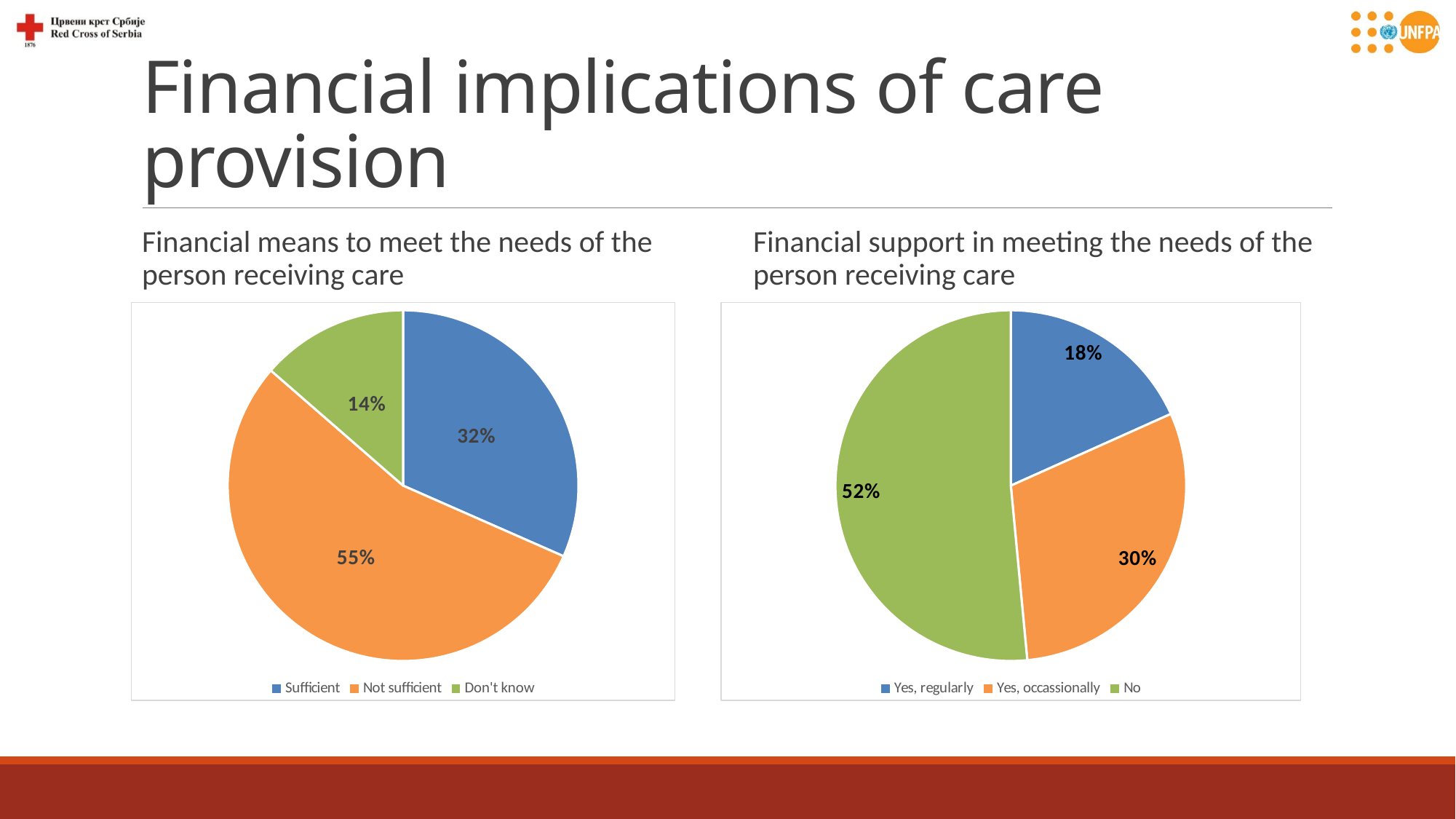
In the 'Financial support in meeting the needs of the person receiving care' chart, what share is labelled 'No'? 52% In the 'Financial support in meeting the needs of the person receiving care' chart, which is larger: 'Yes, regularly' or 'Yes, occassionally'? Yes, occassionally In the 'Financial support in meeting the needs of the person receiving care' chart, what share is labelled 'Yes, occassionally'? 30% In the 'Financial means to meet the needs of the person receiving care' chart, which category has the smallest slice? Don't know What type of chart is used on the left side of the slide? Pie chart In the 'Financial means to meet the needs of the person receiving care' chart, what share is labelled 'Not sufficient'? 55% In the 'Financial means to meet the needs of the person receiving care' chart, what is the difference between the 'Not sufficient' and 'Sufficient' shares? 23 percentage points In the 'Financial means to meet the needs of the person receiving care' chart, what share is labelled 'Don't know'? 14% How many categories does the legend of the 'Financial support in meeting the needs of the person receiving care' chart list? 3 In the 'Financial support in meeting the needs of the person receiving care' chart, what share is labelled 'Yes, regularly'? 18% In the 'Financial means to meet the needs of the person receiving care' chart, which category has the largest slice? Not sufficient In the 'Financial means to meet the needs of the person receiving care' chart, what share is labelled 'Sufficient'? 32%